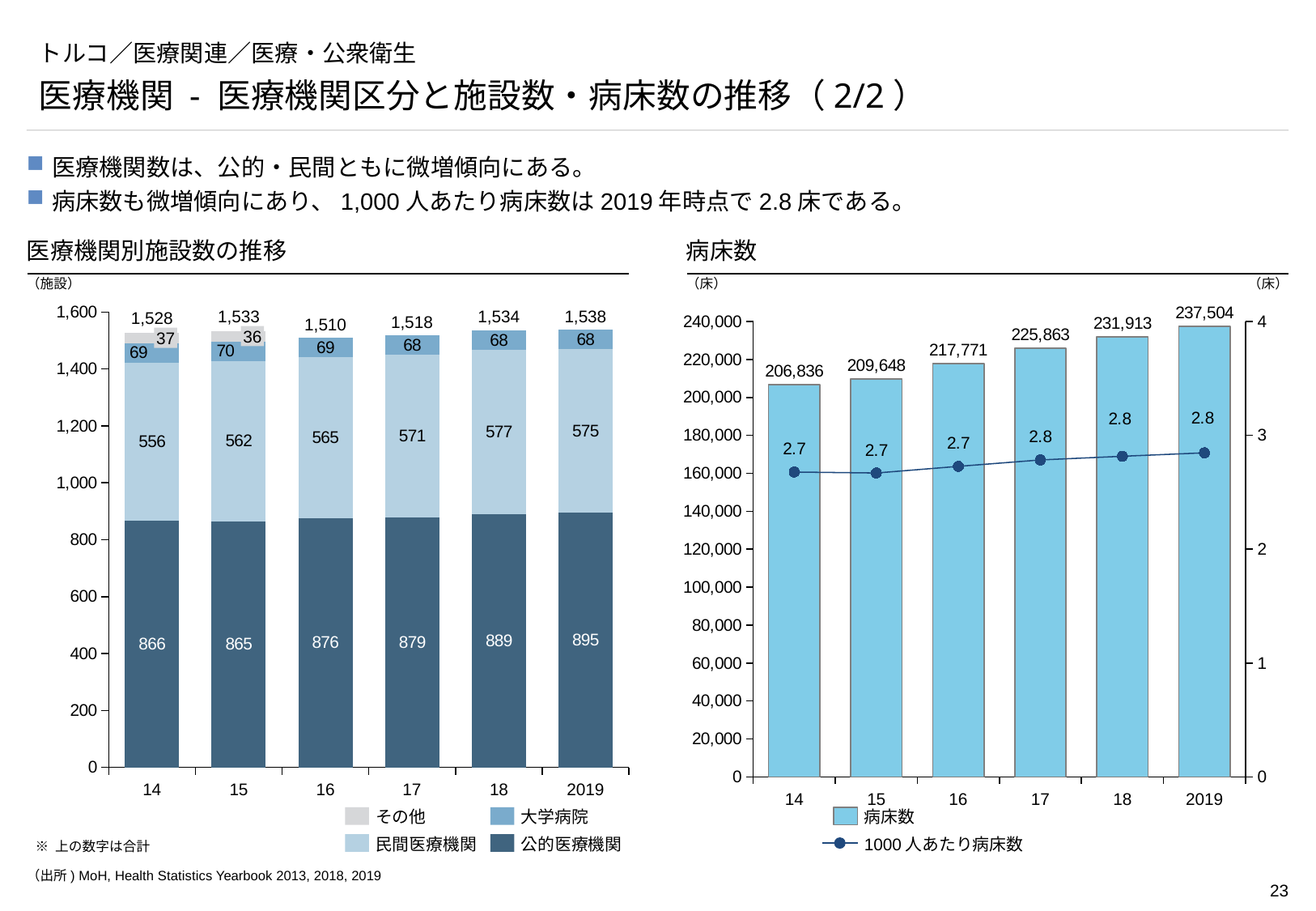
In the 病床数 chart, what is the number of beds (病床数) in 14? 206,836 In the 医療機関別施設数の推移 chart, how many series does the legend list? 4 In the 病床数 chart, what is the number of beds (病床数) in 2019? 237,504 In the 病床数 chart, which year has the highest number of beds (病床数)? 2019 In the 病床数 chart, how many series does the legend list? 2 In the 医療機関別施設数の推移 chart, what is the value for 公的医療機関 in 2019? 895 In the 医療機関別施設数の推移 chart, what is the total number of facilities in 16? 1,510 In the 病床数 chart, what is the value of 1000人あたり病床数 in 17? 2.8 In the 医療機関別施設数の推移 chart, which year has the lowest total number of facilities? 16 In the 医療機関別施設数の推移 chart, what is the value for 民間医療機関 in 18? 577 In the 病床数 chart, do the bed counts rise or fall from 14 to 2019? rise In the 病床数 chart, what is the difference in 病床数 between 2019 and 18? 5,591